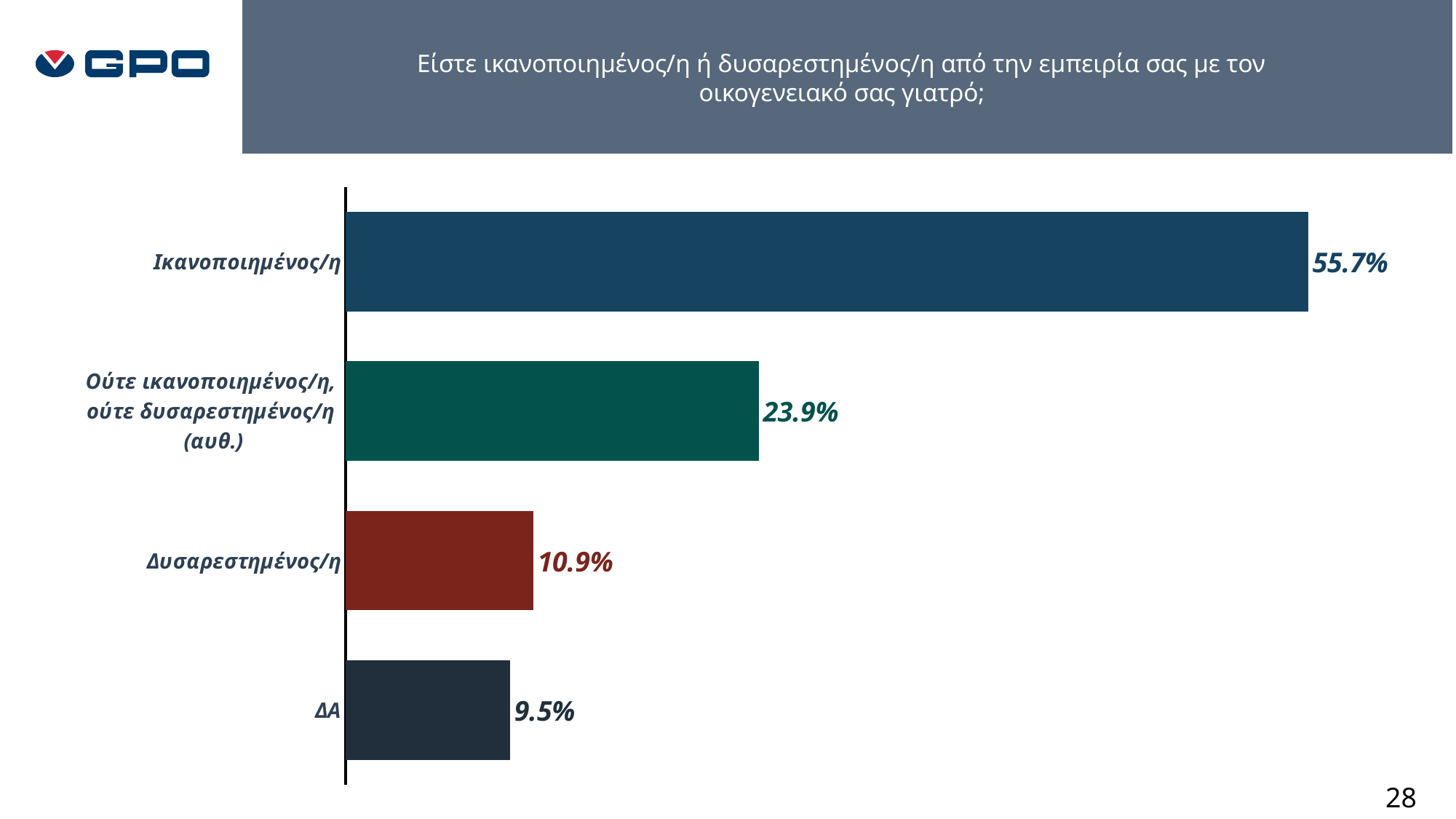
What colour is the bar for Δυσαρεστημένος/η? Dark red How many categories are shown in the chart? 4 Which is larger, the value for Δυσαρεστημένος/η or the value for ΔΑ? Δυσαρεστημένος/η What is the value for Ούτε ικανοποιημένος/η, ούτε δυσαρεστημένος/η (αυθ.)? 23.9% What kind of chart is shown on the slide? Bar chart Which category has the highest value? Ικανοποιημένος/η What is the value for Ικανοποιημένος/η? 55.7% What is the difference between the values for Ικανοποιημένος/η and Δυσαρεστημένος/η? 44.8% What is the difference between the values for Ούτε ικανοποιημένος/η, ούτε δυσαρεστημένος/η (αυθ.) and ΔΑ? 14.4% What is the value for Δυσαρεστημένος/η? 10.9% Which category has the lowest value? ΔΑ What is the value for ΔΑ? 9.5%